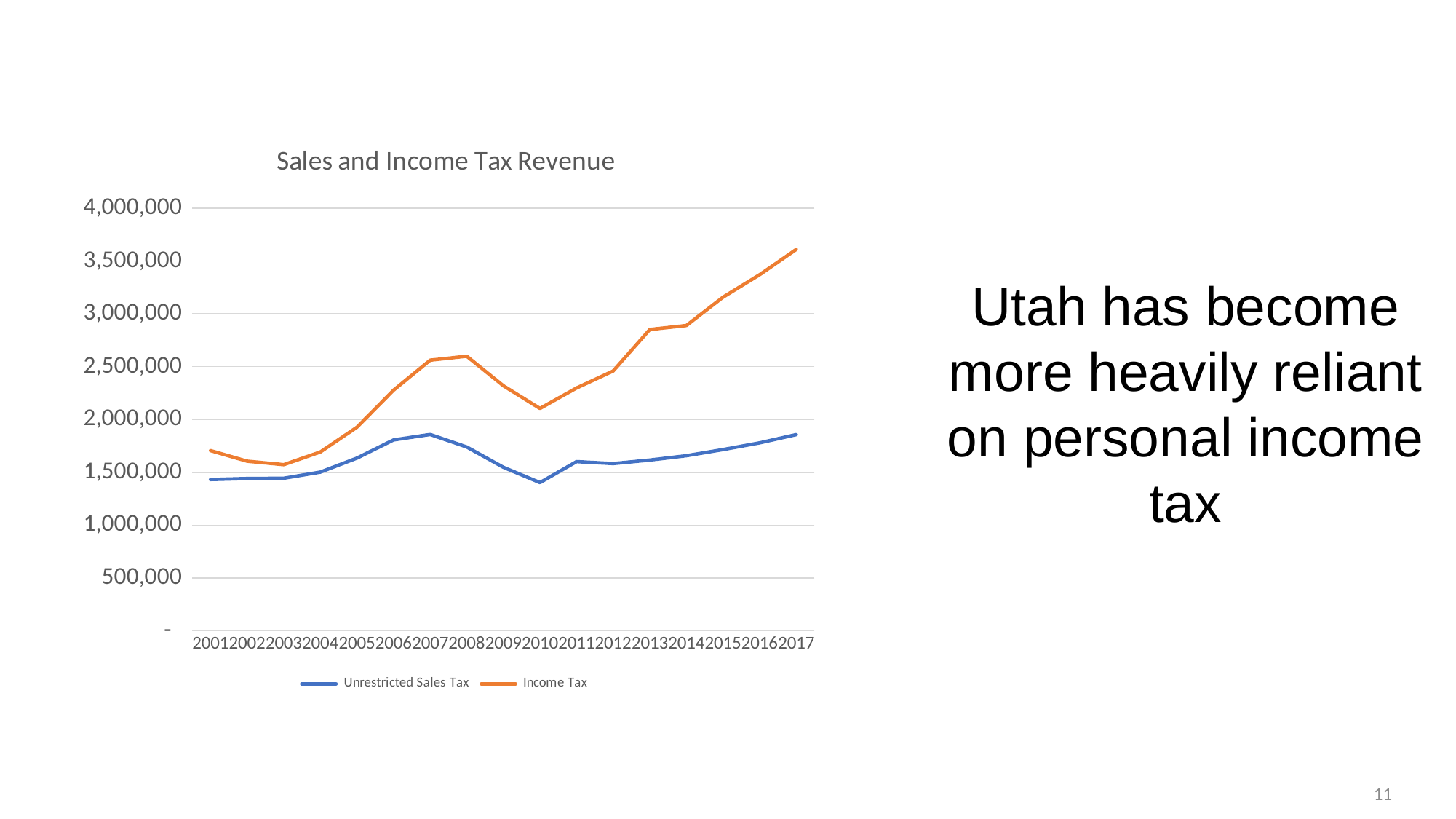
Is the Unrestricted Sales Tax value for 2010 greater or less than 1,500,000? less Is the Income Tax value for 2017 greater or less than 3,500,000? greater In 2017, which is larger: Income Tax or Unrestricted Sales Tax? Income Tax In which year is Income Tax revenue highest? 2017 What is the title of the chart? Sales and Income Tax Revenue How many years are plotted along the x axis? 17 Does Income Tax revenue rise or fall from 2011 to 2017? rise Is the Income Tax value for 2001 greater or less than 2,000,000? less How many series does the legend list? 2 Does Income Tax revenue rise or fall from 2008 to 2010? fall What kind of chart is shown on the slide? line chart